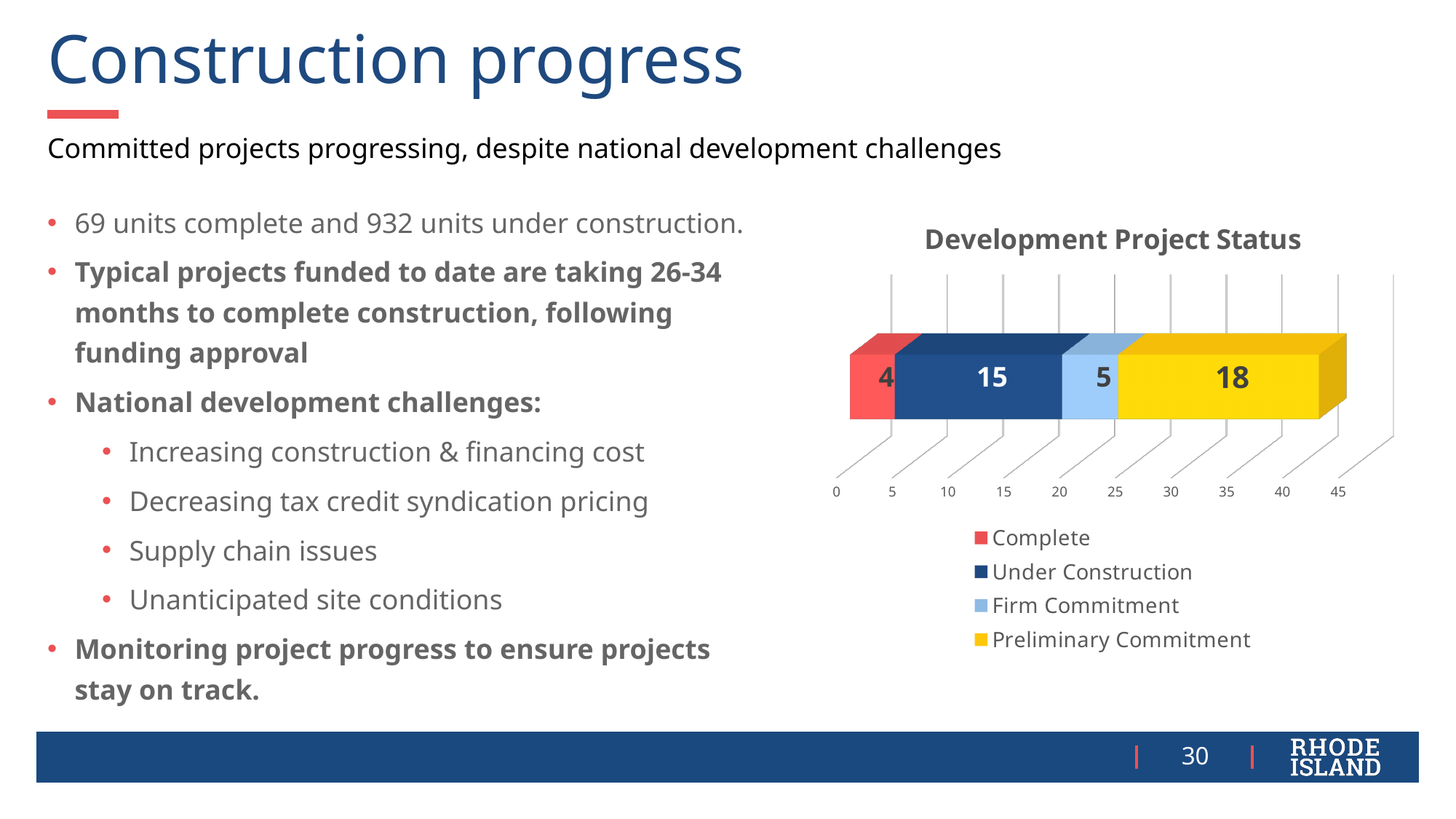
Which series has the highest value in the Development Project Status chart? Preliminary Commitment What kind of chart is the Development Project Status chart? Stacked bar chart What is the value for Preliminary Commitment in the Development Project Status chart? 18 Which series has the lowest value in the Development Project Status chart? Complete What is the total of the stacked bar in the Development Project Status chart? 42 What is the value for Firm Commitment in the Development Project Status chart? 5 What is the difference between the Preliminary Commitment and Under Construction values in the Development Project Status chart? 3 What is the value for Complete in the Development Project Status chart? 4 What colour represents Preliminary Commitment in the Development Project Status chart? Yellow What is the value for Under Construction in the Development Project Status chart? 15 Which is larger in the Development Project Status chart, Under Construction or Firm Commitment? Under Construction How many series does the legend of the Development Project Status chart list? 4